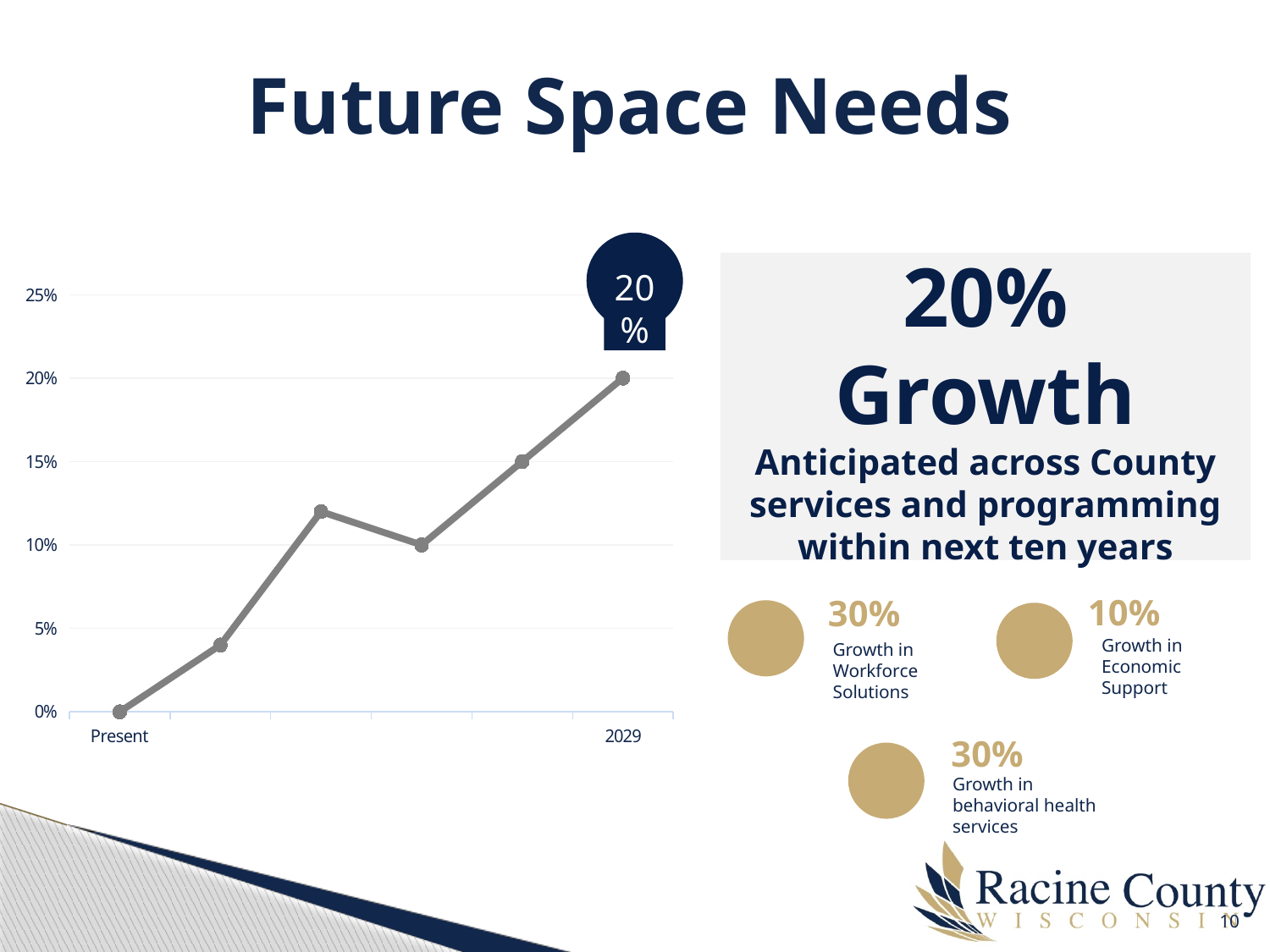
How many data points are plotted on the line chart? 6 Do the values on the line chart generally rise or fall from Present to 2029? rise Is the value for 2029 greater or less than 25%? less What is the value for Present on the line chart? 0% What is the value for 2029 on the line chart? 20% What kind of chart is shown on the slide? line chart Which point on the line chart has the lowest value? Present What is the difference between the value for 2029 and the value for Present? 20% What is the title of the slide containing the line chart? Future Space Needs Which is larger, the value for Present or the value for 2029? 2029 Which point on the line chart has the highest value, Present or 2029? 2029 What is the highest value shown on the y axis of the line chart? 25%